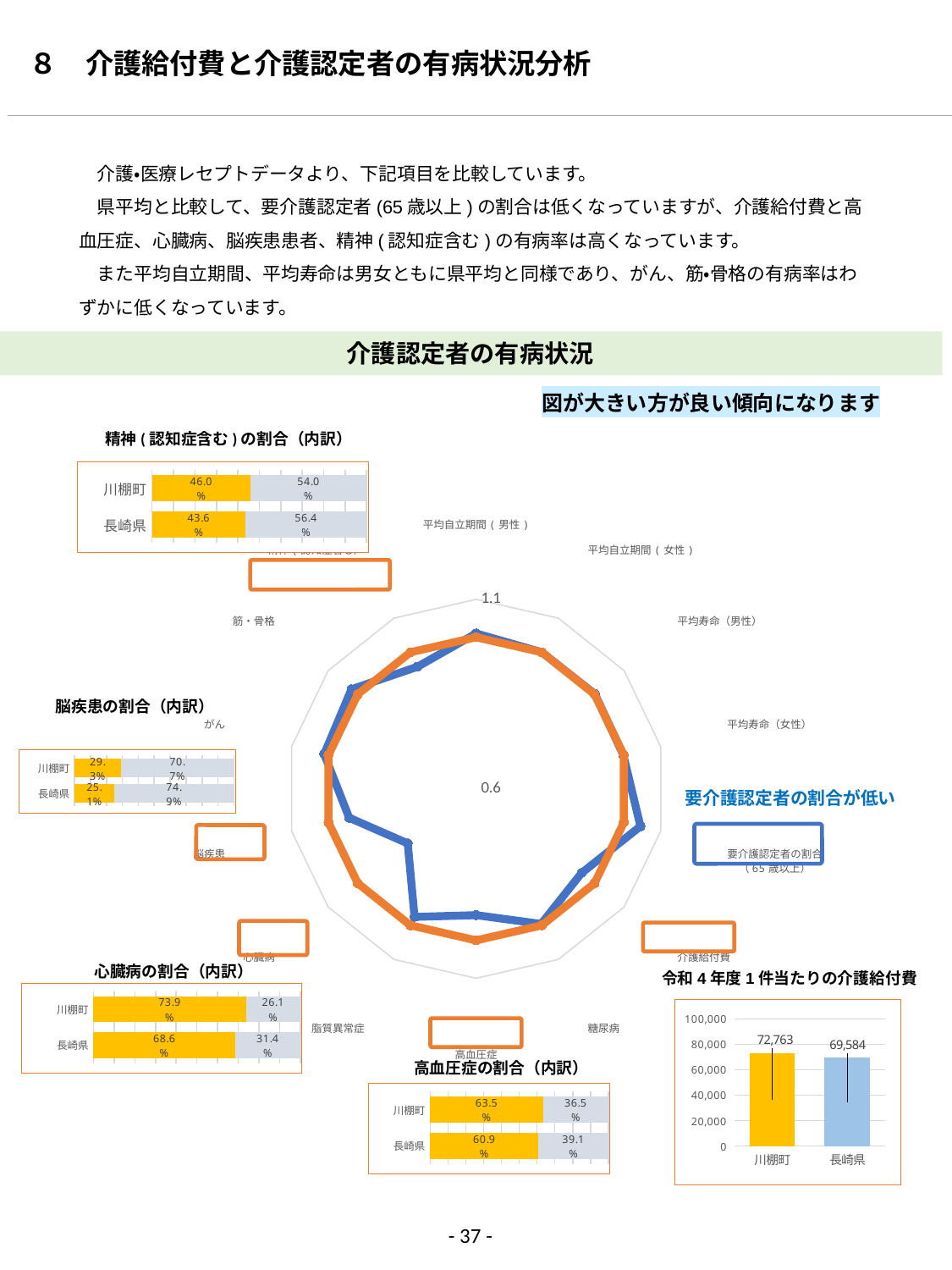
In the chart titled 令和4年度1件当たりの介護給付費, what is the value for 長崎県? 69,584 In the chart titled 脳疾患の割合(内訳), what is the yellow segment value for 川棚町? 29.3% In the chart titled 令和4年度1件当たりの介護給付費, which category has the higher value? 川棚町 In the chart titled 令和4年度1件当たりの介護給付費, what is the difference between the values for 川棚町 and 長崎県? 3,179 In the chart titled 心臓病の割合(内訳), what is the yellow segment value for 川棚町? 73.9% In the chart titled 精神(認知症含む)の割合(内訳), what is the yellow segment value for 川棚町? 46.0% In the chart titled 令和4年度1件当たりの介護給付費, what kind of chart is shown? Bar chart In the chart titled 令和4年度1件当たりの介護給付費, what is the value for 川棚町? 72,763 In the chart titled 高血圧症の割合(内訳), what is the grey segment value for 長崎県? 39.1% In the chart titled 精神(認知症含む)の割合(内訳), what is the grey segment value for 長崎県? 56.4% In the chart titled 心臓病の割合(内訳), which row has the larger yellow segment, 川棚町 or 長崎県? 川棚町 In the chart titled 令和4年度1件当たりの介護給付費, how many categories are shown on the x axis? 2